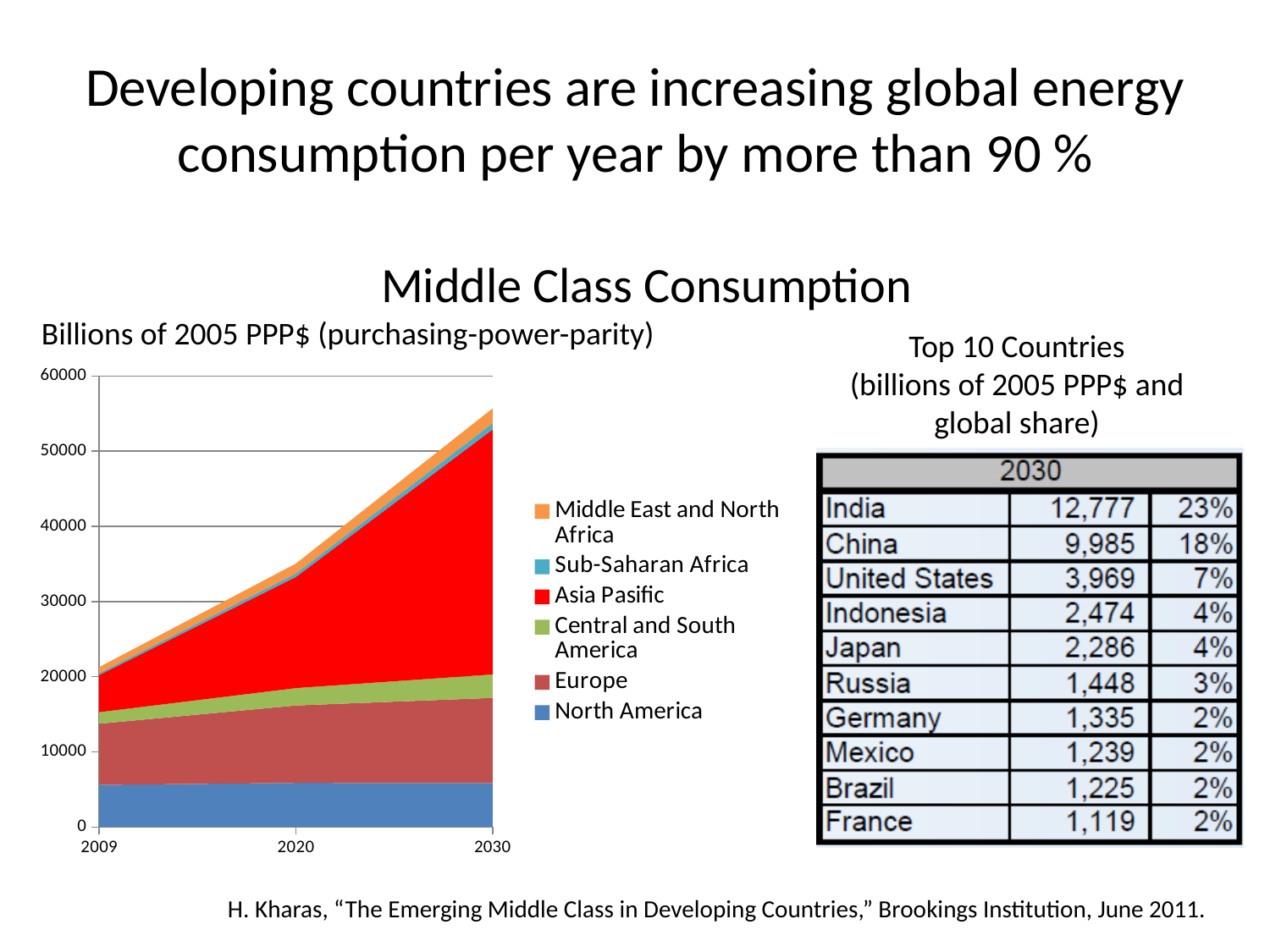
Is the total middle class consumption in 2030 greater or less than 50000? greater How many series does the legend of the Middle Class Consumption chart list? 6 Which region has the largest middle class consumption in 2030 in the chart? Asia Pasific What kind of chart is the Middle Class Consumption chart? Stacked area chart Does total middle class consumption rise or fall from 2009 to 2030 in the chart? Rise What unit is stated above the Middle Class Consumption chart? Billions of 2005 PPP$ (purchasing-power-parity) Is the North America value in 2030 greater or less than 10000? less Is the total middle class consumption in 2009 greater or less than 30000? less How many years are shown on the x axis of the Middle Class Consumption chart? 3 In 2030, which is larger in the chart: Asia Pasific or North America? Asia Pasific Which colour represents Europe in the Middle Class Consumption chart? Brownish red